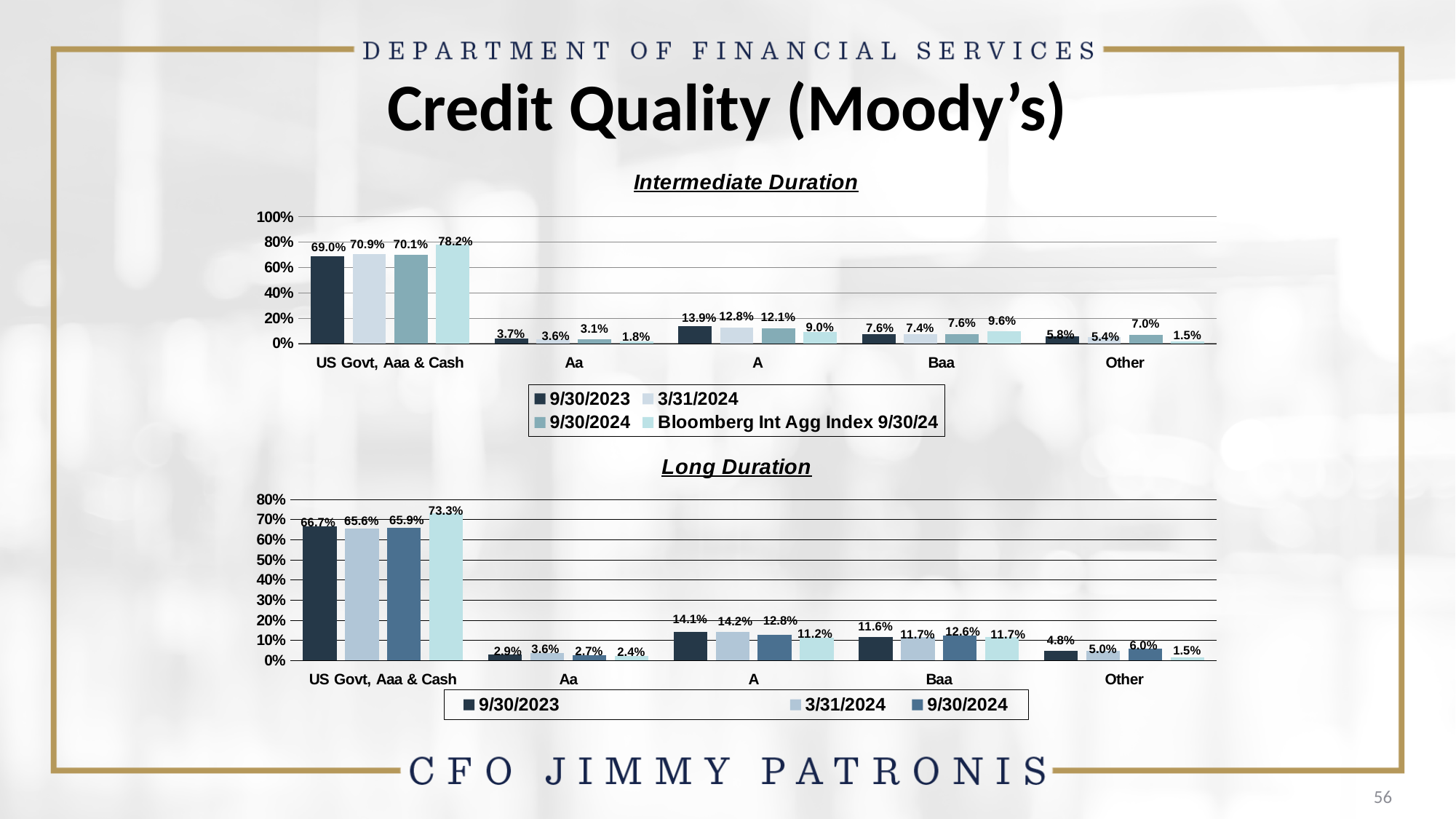
In the Long Duration chart, which category has the lowest value for the 3/31/2024 series? Aa In the Intermediate Duration chart, what is the difference between the 9/30/2023 and 9/30/2024 values for Other? 1.2% In the Intermediate Duration chart, what is the value for A for the Bloomberg Int Agg Index 9/30/24 series? 9.0% In the Long Duration chart, what is the value for Other for the 9/30/2023 series? 4.8% How many series does the legend of the Intermediate Duration chart list? 4 What kind of chart is the Long Duration chart? Bar chart In the Intermediate Duration chart, which is larger for Baa: the 9/30/2023 value or the Bloomberg Int Agg Index 9/30/24 value? Bloomberg Int Agg Index 9/30/24 In the Intermediate Duration chart, which category has the highest value for the 9/30/2023 series? US Govt, Aaa & Cash In the Intermediate Duration chart, what is the value for US Govt, Aaa & Cash for the 9/30/2024 series? 70.1% How many categories are shown on the x axis of the Long Duration chart? 5 In the Long Duration chart, what is the value for Baa for the 9/30/2024 series? 12.6%